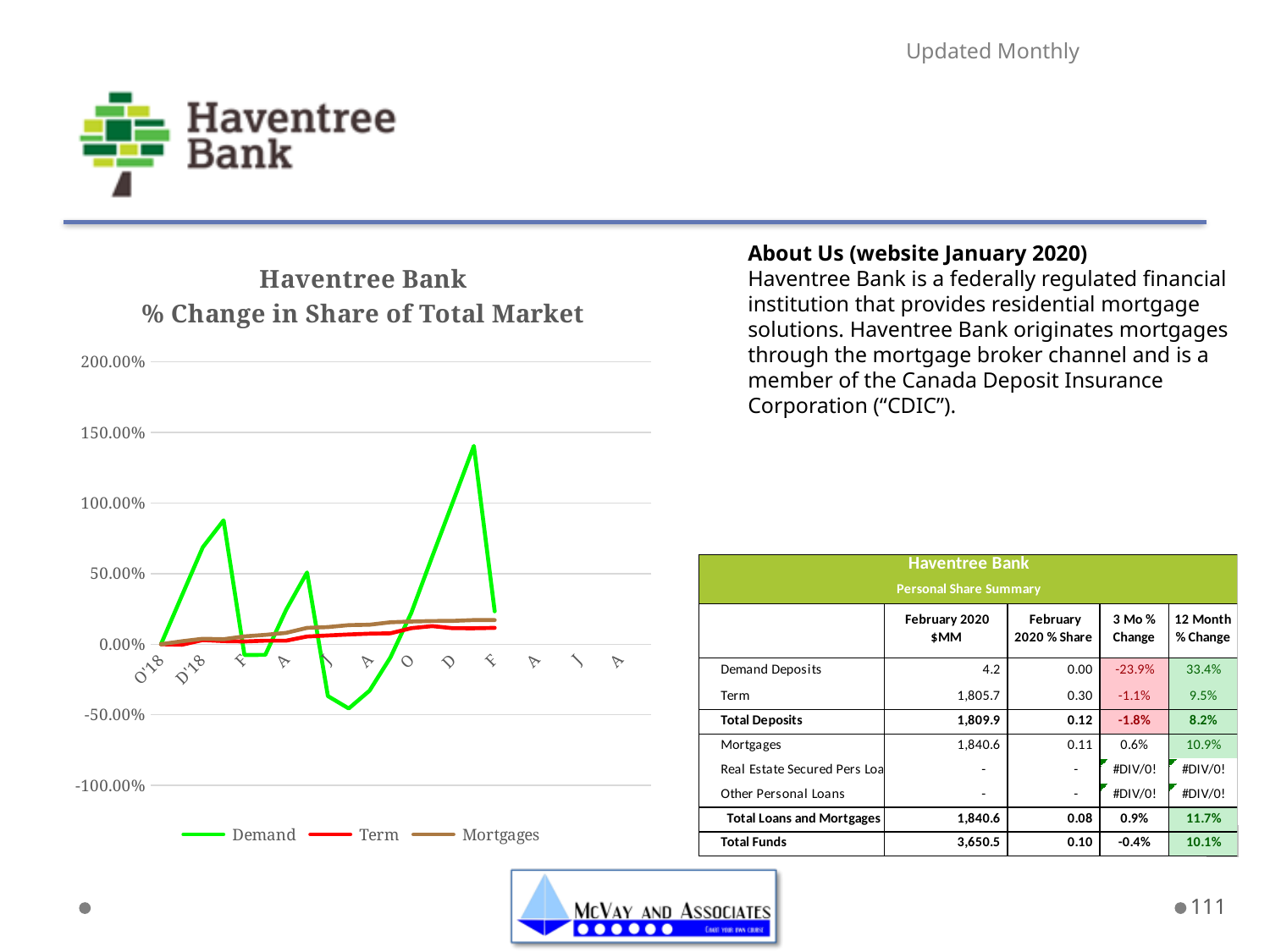
How many series does the legend of the "% Change in Share of Total Market" chart list? 3 Is the highest value of the Mortgages line greater or less than 50.00%? less What is the highest value shown on the y-axis of the "% Change in Share of Total Market" chart? 200.00% Is the highest value of the Demand line greater or less than 100.00%? greater Is the lowest value of the Demand line greater or less than 0.00%? less Which series are listed in the legend of the "% Change in Share of Total Market" chart? Demand, Term, Mortgages Does the Mortgages line generally rise or fall from O'18 to the last plotted point? rise Which series reaches the highest peak in the "% Change in Share of Total Market" chart? Demand Which series drops to the lowest value in the "% Change in Share of Total Market" chart? Demand What kind of chart is shown under the title "Haventree Bank % Change in Share of Total Market"? line chart What colour is the Demand line in the "% Change in Share of Total Market" chart? green